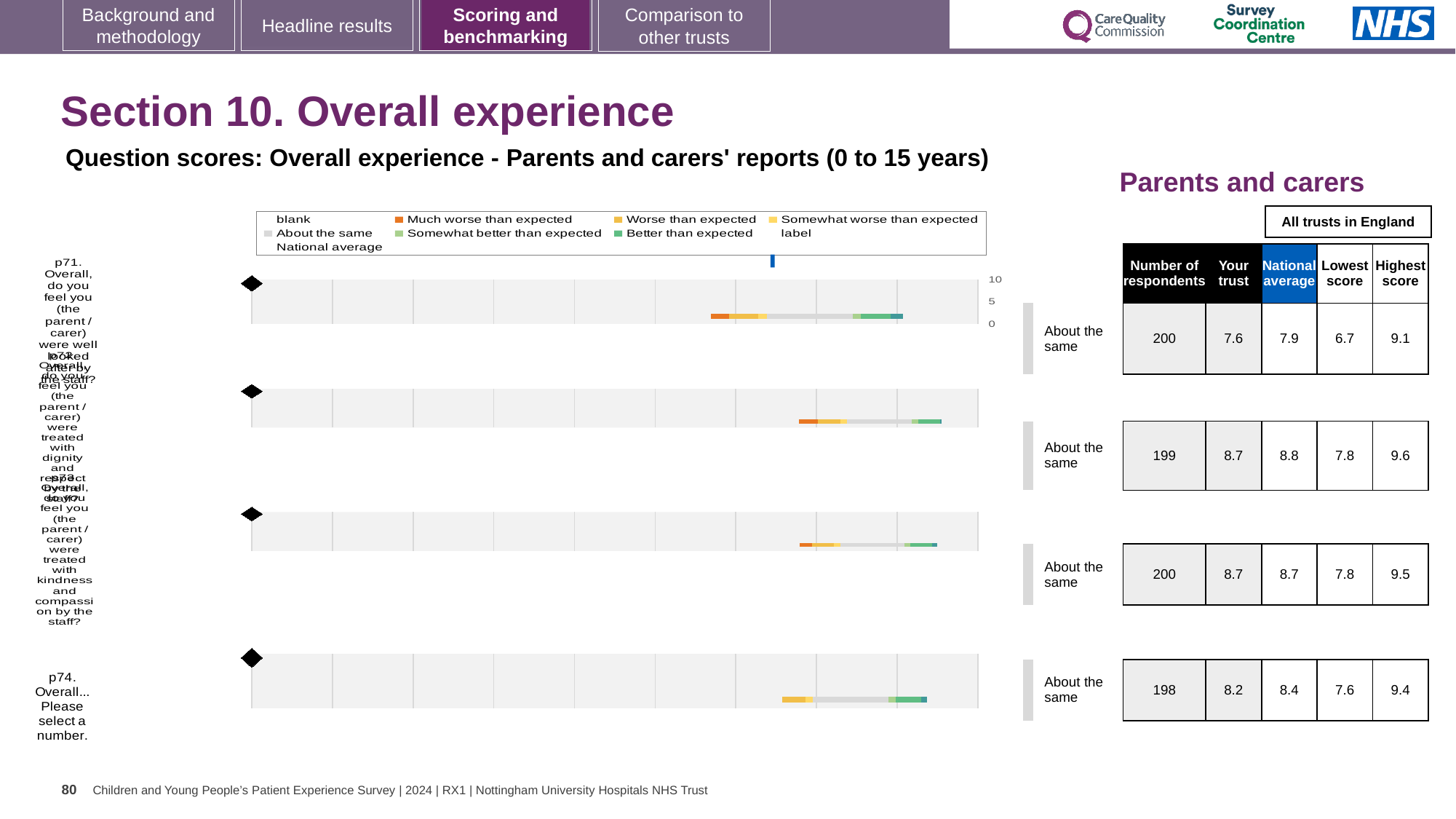
Which question has the lowest 'Your trust' score? p71 What is the highest score across all trusts in England for p73? 9.5 How many questions (rows) are plotted in the chart? 4 For p74, which is larger: the 'Your trust' score or the national average? National average What kind of chart is used to show the question scores on this slide? bar chart What benchmark category is shown for p71? About the same What is the 'Your trust' score for p71 (Overall, do you feel you were well looked after by the staff?)? 7.6 How many entries does the chart legend list? 9 How many respondents answered p72? 199 What is the national average score for p74 (Overall... Please select a number)? 8.4 What is the difference between the national average and the 'Your trust' score for p71? 0.3 What is the subtitle of the chart on this slide? Question scores: Overall experience - Parents and carers' reports (0 to 15 years)